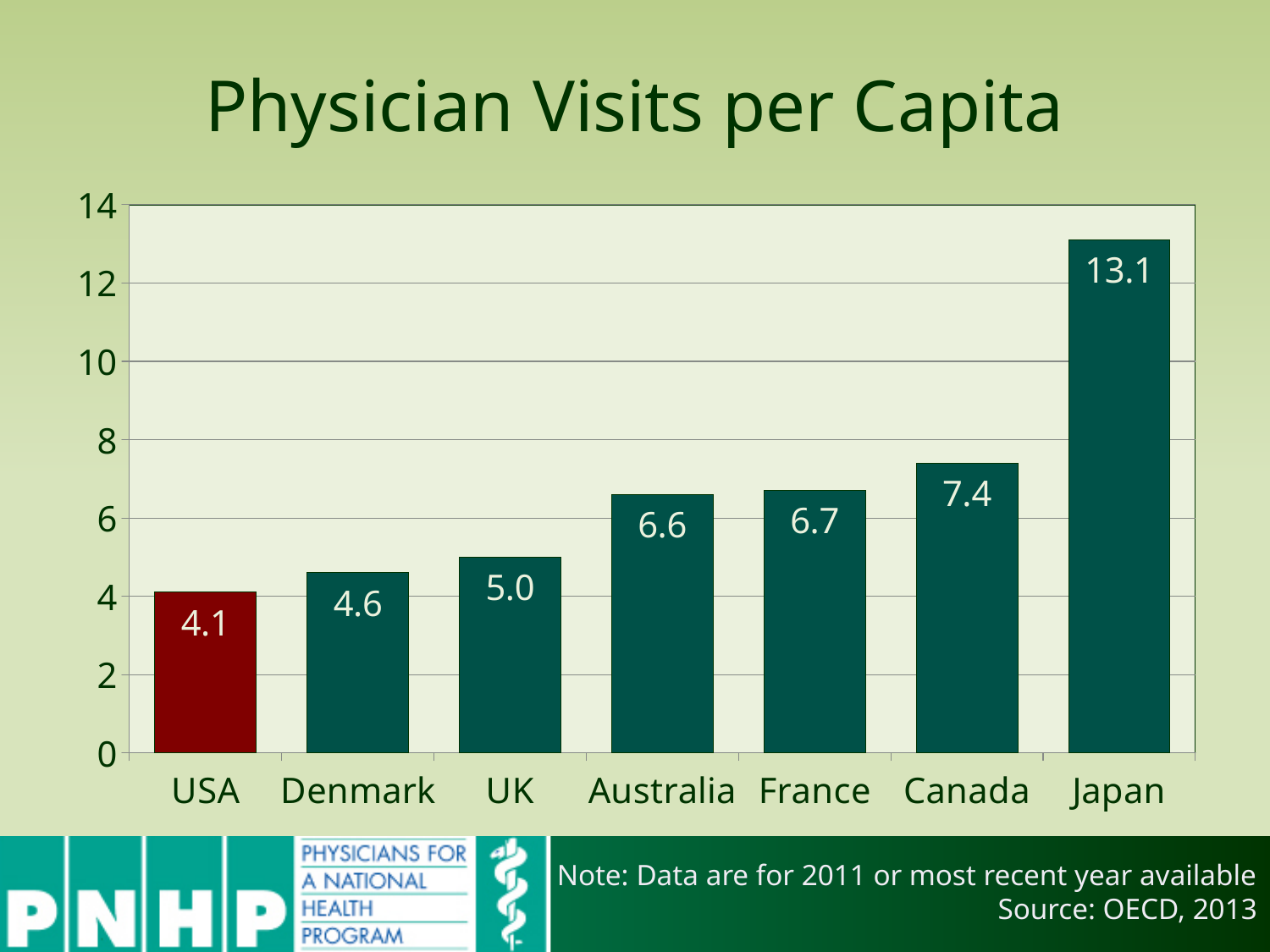
Which is larger, the value for Australia or the value for UK? Australia What is the difference between the values for Japan and the USA? 9.0 Which bar is coloured differently from the others? USA Is the value for Canada greater or less than 8? less Which country has the highest number of physician visits per capita? Japan What kind of chart is shown on the slide? bar chart How many countries are shown in the chart? 7 What is the value for Japan? 13.1 Which country has the lowest number of physician visits per capita? USA What is the value for Canada? 7.4 What is the value for the USA? 4.1 What is the difference between the values for Canada and Denmark? 2.8